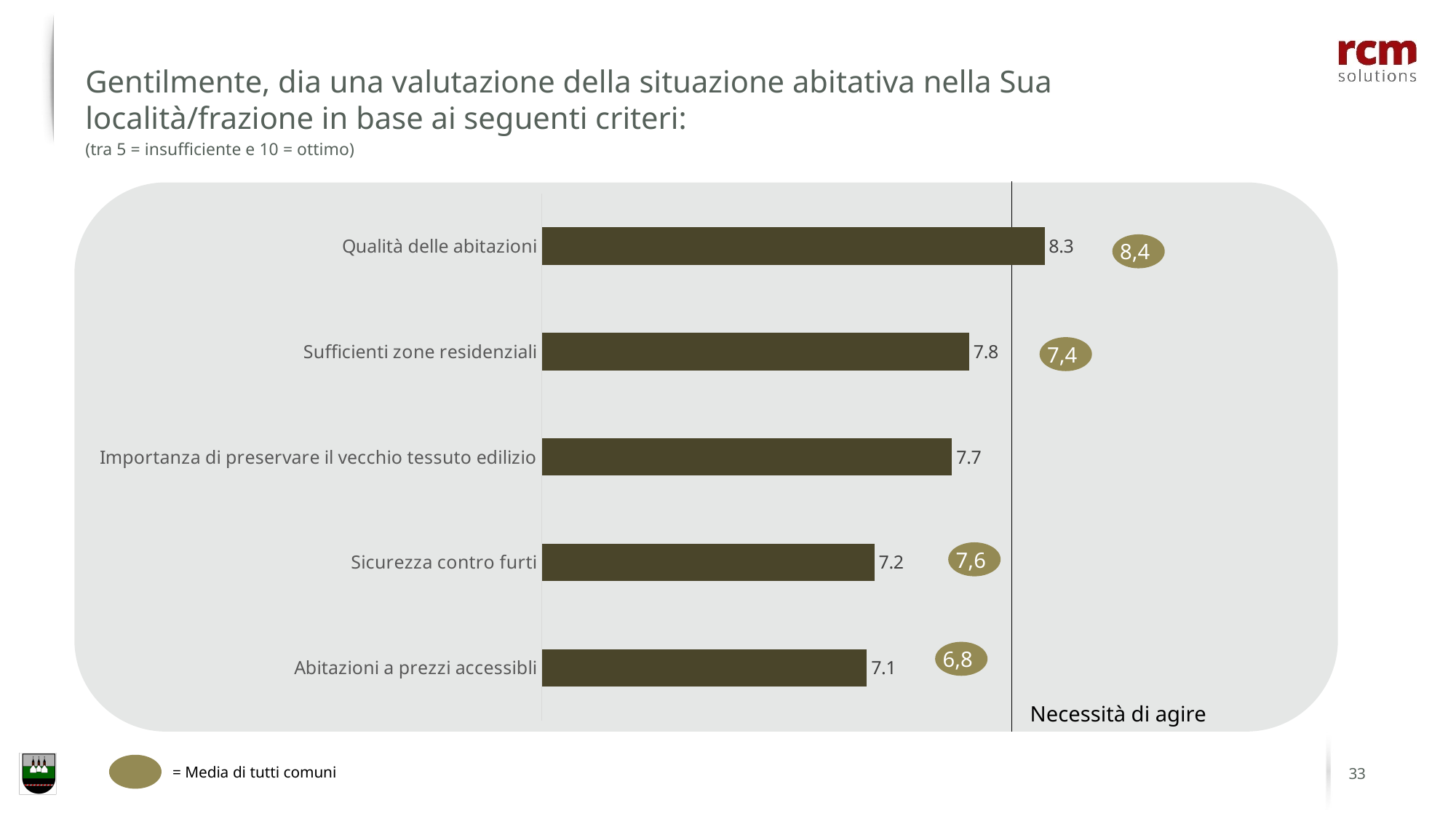
Which category has the lowest value? Abitazioni a prezzi accessibli What is the difference between the values for "Qualità delle abitazioni" and "Sicurezza contro furti"? 1.1 Which category has the highest value? Qualità delle abitazioni What kind of chart is shown on the slide? Bar chart What is the value for "Importanza di preservare il vecchio tessuto edilizio"? 7.7 How many categories are shown in the chart? 5 What label is written next to the vertical line on the right side of the chart? Necessità di agire Which is larger, the value for "Sufficienti zone residenziali" or the value for "Sicurezza contro furti"? Sufficienti zone residenziali What is the value for "Qualità delle abitazioni"? 8.3 What is the "Media di tutti comuni" value shown in the oval next to "Sicurezza contro furti"? 7,6 What is the value for "Abitazioni a prezzi accessibli"? 7.1 What is the value for "Sufficienti zone residenziali"? 7.8